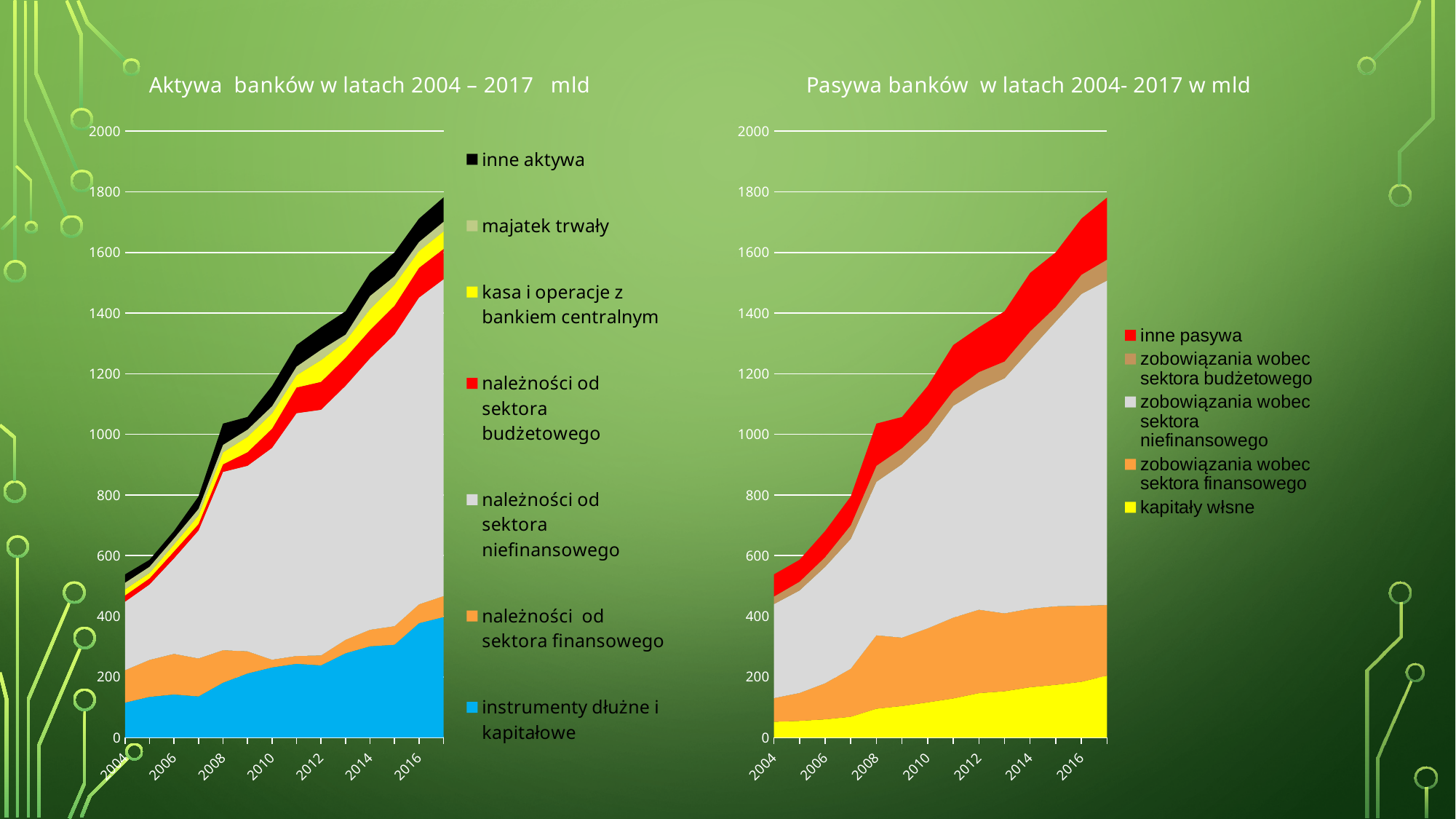
In the 'Pasywa banków w latach 2004- 2017 w mld' chart, do the total liabilities rise or fall from 2004 to 2017? rise In the 'Pasywa banków w latach 2004- 2017 w mld' chart, is the total value for 2010 greater or less than 1000? greater In the 'Aktywa banków w latach 2004 – 2017 mld' chart, do the total assets rise or fall from 2004 to 2017? rise How many series does the legend of the 'Aktywa banków w latach 2004 – 2017 mld' chart list? 7 In the 'Aktywa banków w latach 2004 – 2017 mld' chart, is the total value for 2017 greater or less than 1600? greater What kind of chart is the 'Aktywa banków w latach 2004 – 2017 mld' chart? stacked area chart In the 'Aktywa banków w latach 2004 – 2017 mld' chart, which year has the highest total value? 2017 In the 'Aktywa banków w latach 2004 – 2017 mld' chart, is the total value for 2004 greater or less than 600? less In the 'Pasywa banków w latach 2004- 2017 w mld' chart, which series is shown in yellow? kapitały włsne In the 'Aktywa banków w latach 2004 – 2017 mld' chart, which series is shown in blue? instrumenty dłużne i kapitałowe How many series does the legend of the 'Pasywa banków w latach 2004- 2017 w mld' chart list? 5